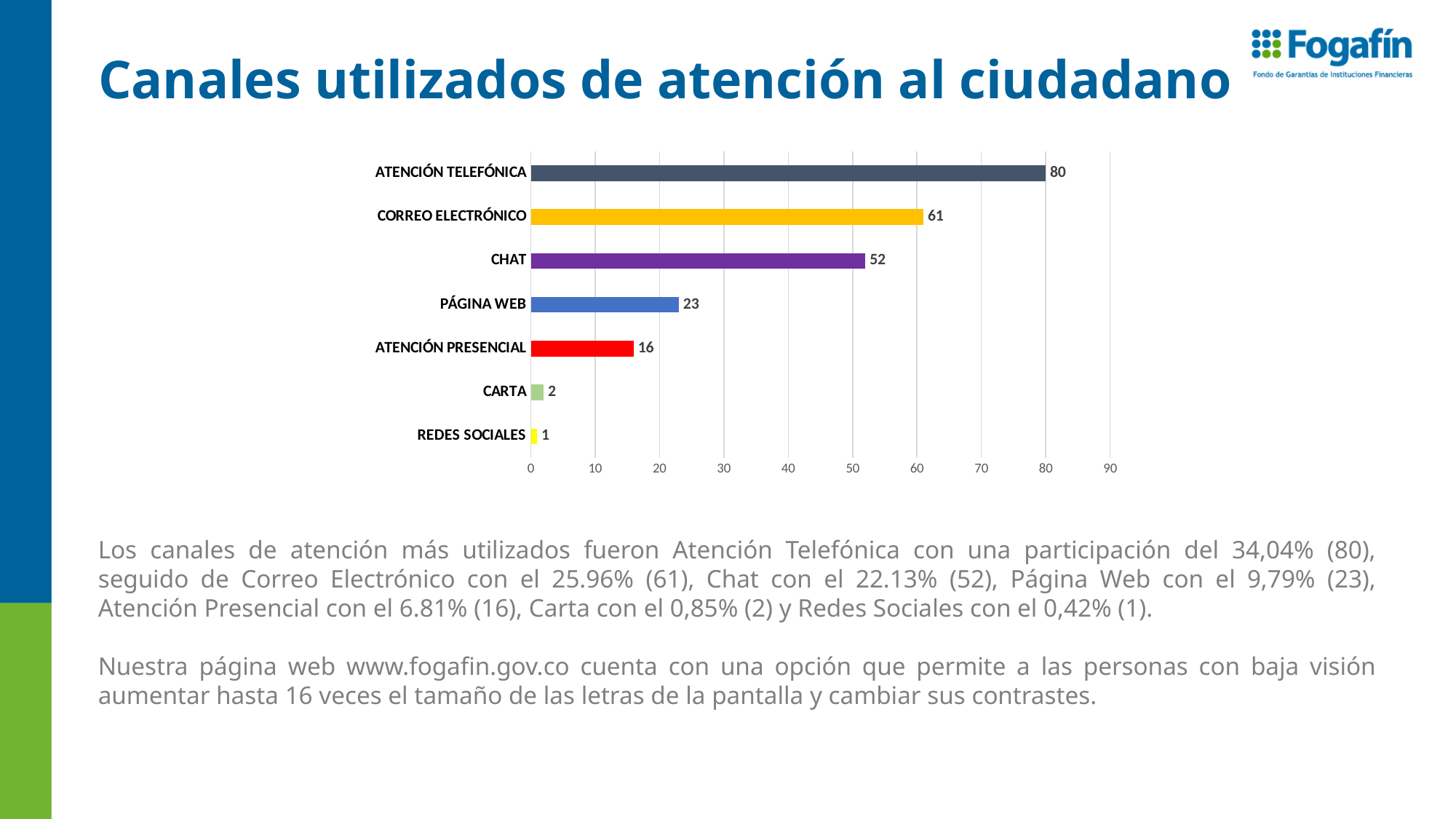
What colour is the bar for ATENCIÓN PRESENCIAL? red Which is larger, the value for PÁGINA WEB or the value for ATENCIÓN PRESENCIAL? PÁGINA WEB How many categories are shown in the chart? 7 Is the value for CHAT greater or less than 50? greater What kind of chart is shown on the slide? bar chart What is the difference between the values for CORREO ELECTRÓNICO and CHAT? 9 What is the value for CORREO ELECTRÓNICO? 61 What is the value for CARTA? 2 What is the value for PÁGINA WEB? 23 Which category has the lowest value? REDES SOCIALES Which category has the highest value? ATENCIÓN TELEFÓNICA What is the value for ATENCIÓN TELEFÓNICA? 80